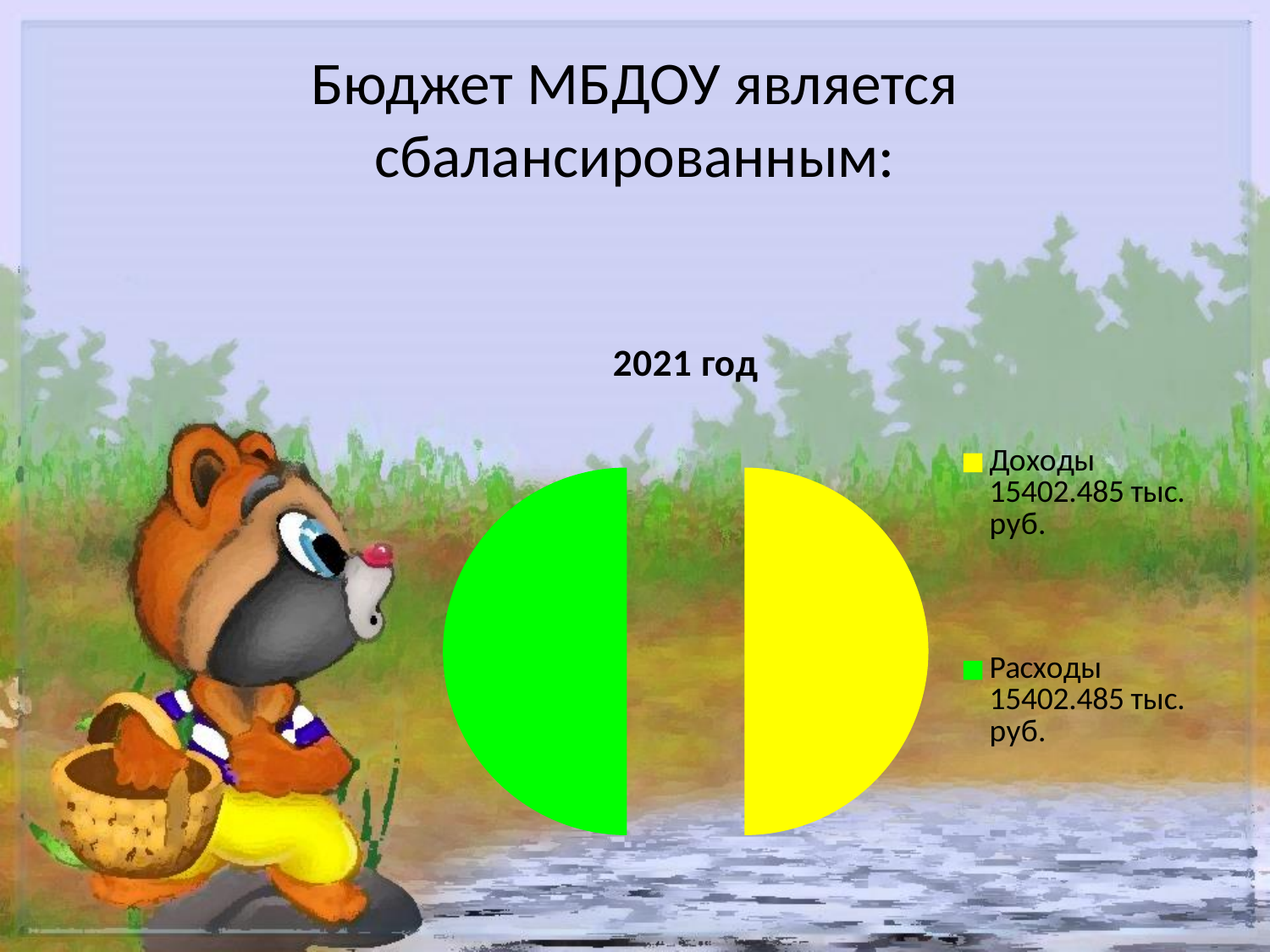
How many slices does the pie chart have? 2 What kind of chart is shown on the slide? pie chart Is the value for Доходы greater or less than 10000 тыс. руб.? greater What is the title of the chart? 2021 год What is the difference between the Доходы and Расходы values? 0 What value is given for Расходы in the chart legend? 15402.485 тыс. руб. What share of the pie does the Доходы slice represent? 50% Which colour represents Расходы in the pie chart? green What share of the pie does the Расходы slice represent? 50% How many entries does the chart legend list? 2 What value is given for Доходы in the chart legend? 15402.485 тыс. руб.